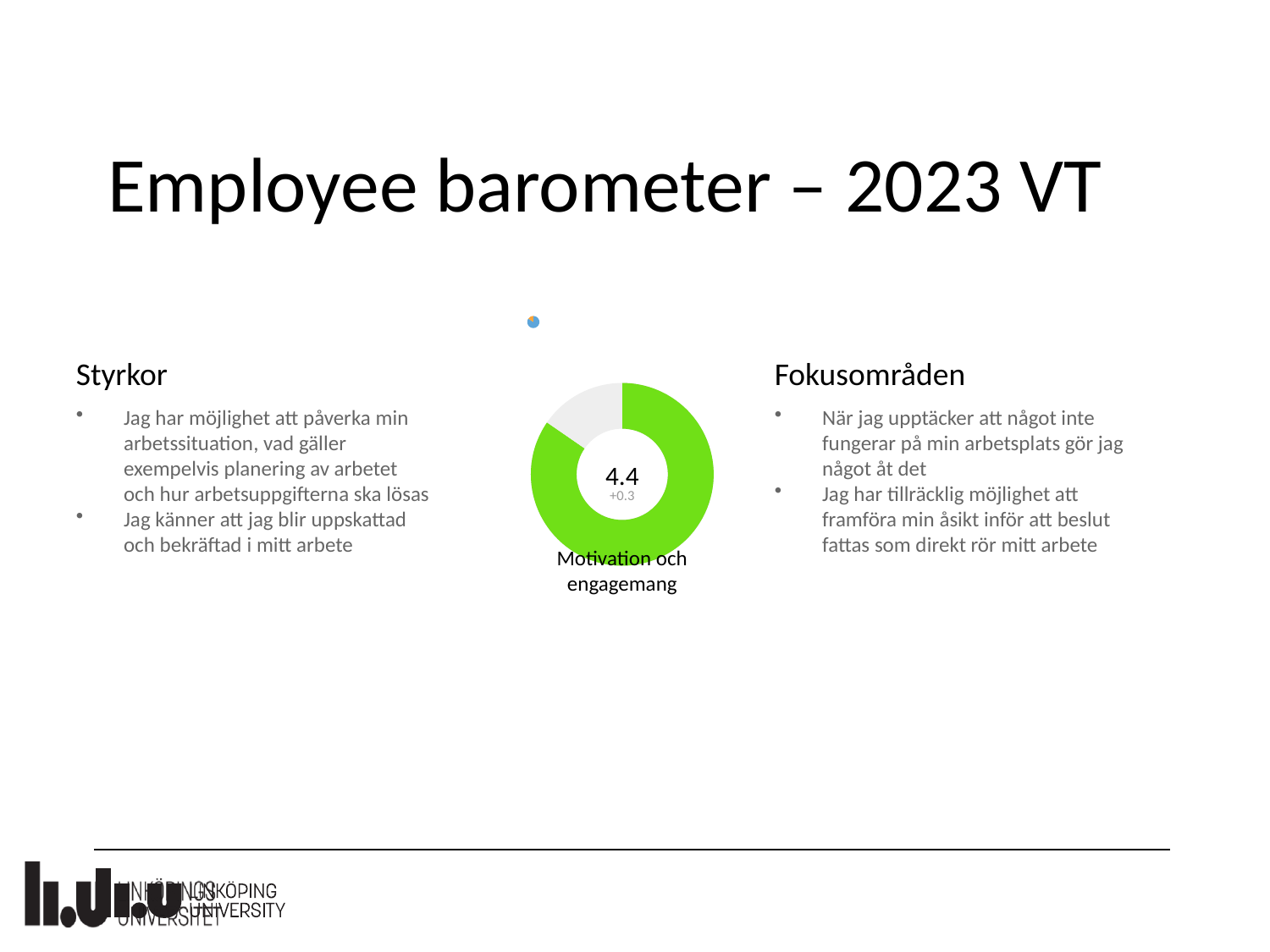
Which colour fills the larger portion of the donut chart? green Is the green portion of the donut chart larger or smaller than the grey portion? larger What value is printed in the centre of the donut chart? 4.4 What kind of chart is shown on the slide? donut chart What is the label printed below the donut chart? Motivation och engagemang What change value is printed beneath the main value in the centre of the donut chart? +0.3 Does the change value shown in the centre of the donut chart indicate an increase or a decrease? increase